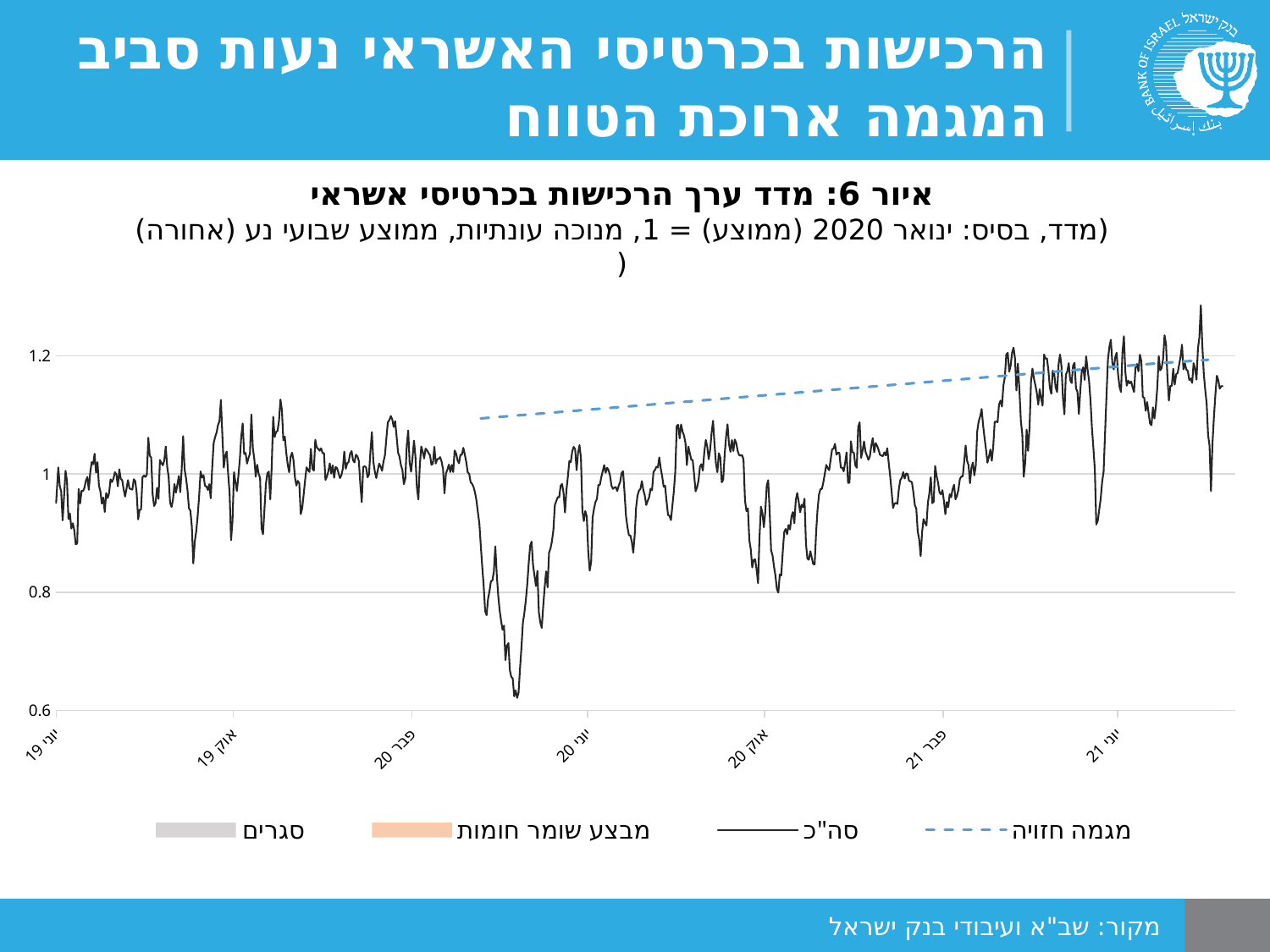
How many labelled tick marks are there on the x axis? 7 Which is larger: the value of the סה"כ line at יוני 21 or at יוני 20? יוני 21 How many entries does the chart legend list? 4 Between which two x-axis labels does the lowest point of the סה"כ line occur? פבר 20 and יוני 20 What is the lowest value labelled on the y axis? 0.6 Which legend entry is drawn as a dashed blue line? מגמה חזויה What kind of chart is shown on the slide? line chart Does the dashed מגמה חזויה line rise or fall from left to right? rises Is the highest peak of the סה"כ line, reached in 2021, greater or less than 1.2? greater In which year does the סה"כ line reach its highest values? 2021 What is the title of the chart? איור 6: מדד ערך הרכישות בכרטיסי אשראי Is the lowest point of the סה"כ line greater or less than 0.8? less